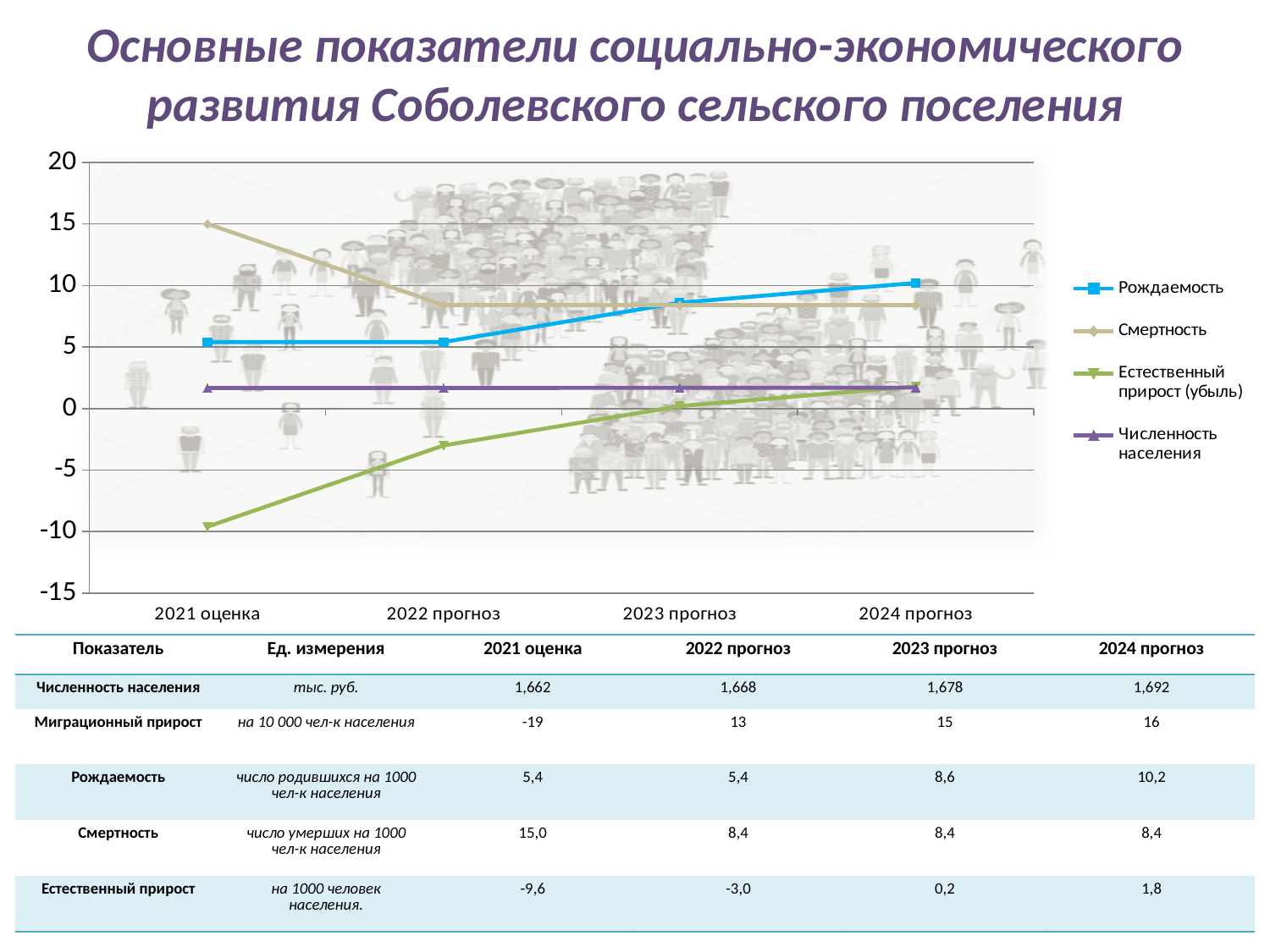
What is the value of Смертность for 2021 оценка? 15,0 In which year is Естественный прирост (убыль) lowest? 2021 оценка Is the value of Естественный прирост for 2021 оценка greater or less than -5? less Does Рождаемость rise or fall from 2022 прогноз to 2024 прогноз? rise In which year is Смертность highest? 2021 оценка Which is larger in 2024 прогноз, Рождаемость or Смертность? Рождаемость What is the value of Рождаемость for 2024 прогноз? 10,2 What kind of chart is shown on the slide? line chart What is the difference between Смертность and Рождаемость in 2021 оценка? 9,6 How many series does the chart legend list? 4 How many x-axis categories does the chart have? 4 What is the value of Естественный прирост for 2022 прогноз? -3,0